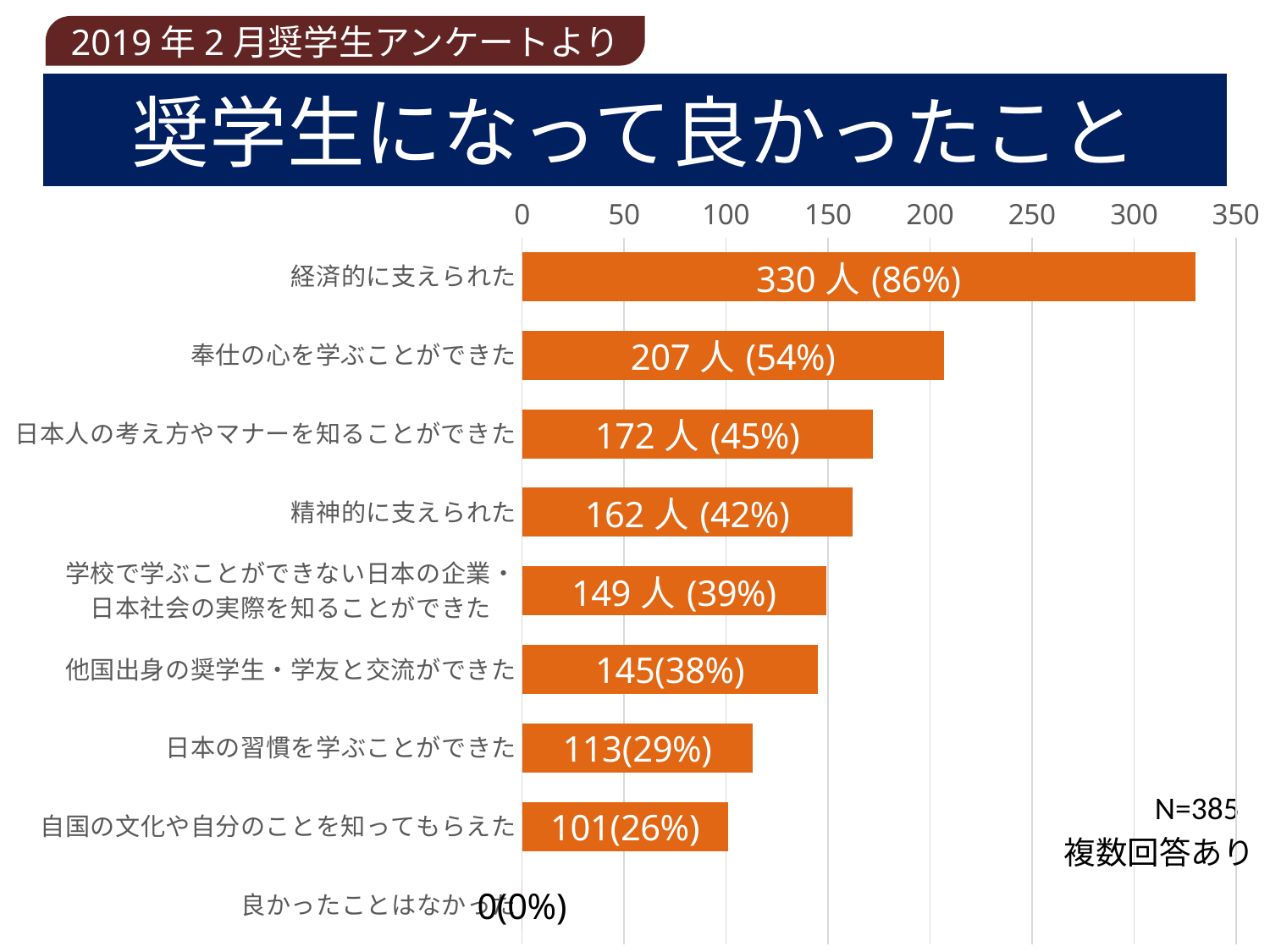
Is the value for 他国出身の奨学生・学友と交流ができた greater or less than 100? greater What is the value shown for 奉仕の心を学ぶことができた? 207 人 (54%) What is the value shown for 経済的に支えられた? 330 人 (86%) How many categories are shown on the chart? 9 What is the value shown for 日本の習慣を学ぶことができた? 113(29%) What kind of chart is shown on the slide? bar chart Which is larger: the value for 日本人の考え方やマナーを知ることができた or the value for 精神的に支えられた? 日本人の考え方やマナーを知ることができた Which category with a non-zero value has the lowest value? 自国の文化や自分のことを知ってもらえた What is the difference in number of people between 経済的に支えられた and 奉仕の心を学ぶことができた? 123 What is the N value noted on the chart? N=385 Which category has the highest value? 経済的に支えられた What is the value shown for 精神的に支えられた? 162 人 (42%)